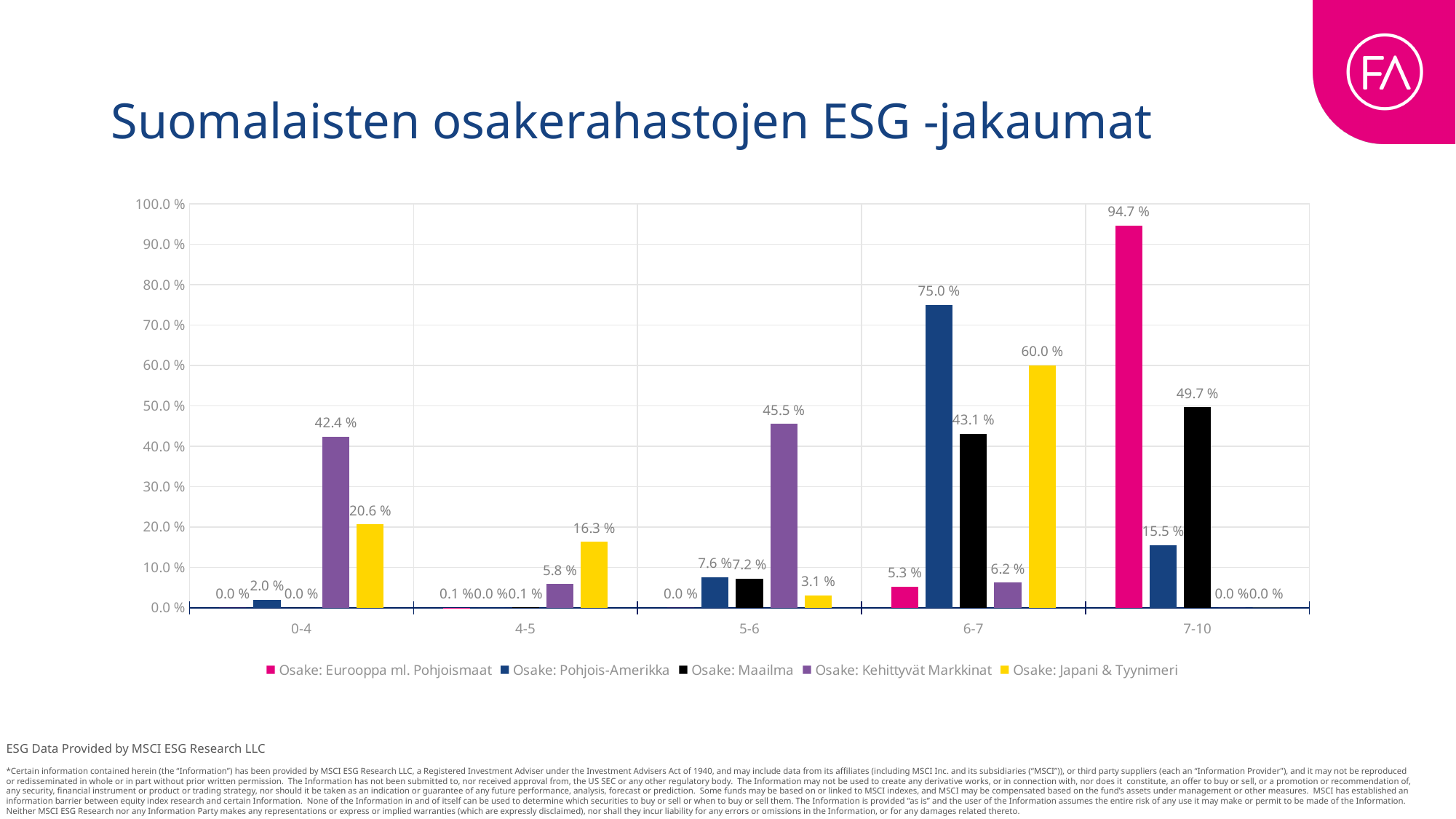
What is the difference between the Osake: Pohjois-Amerikka and Osake: Maailma values in the 6-7 category? 31.9 % What kind of chart is shown on the slide? Bar chart Is the value for Osake: Japani & Tyynimeri in the 6-7 category greater or less than 50.0 %? greater What is the value for Osake: Japani & Tyynimeri in the 4-5 category? 16.3 % How many categories are shown on the x axis? 5 What is the value for Osake: Pohjois-Amerikka in the 6-7 category? 75.0 % How many series does the legend list? 5 Which series has the highest value in the 0-4 category? Osake: Kehittyvät Markkinat Which category has the lowest value for Osake: Japani & Tyynimeri? 7-10 What is the value for Osake: Eurooppa ml. Pohjoismaat in the 7-10 category? 94.7 % What is the value for Osake: Kehittyvät Markkinat in the 5-6 category? 45.5 % In the 7-10 category, which is larger: Osake: Maailma or Osake: Pohjois-Amerikka? Osake: Maailma